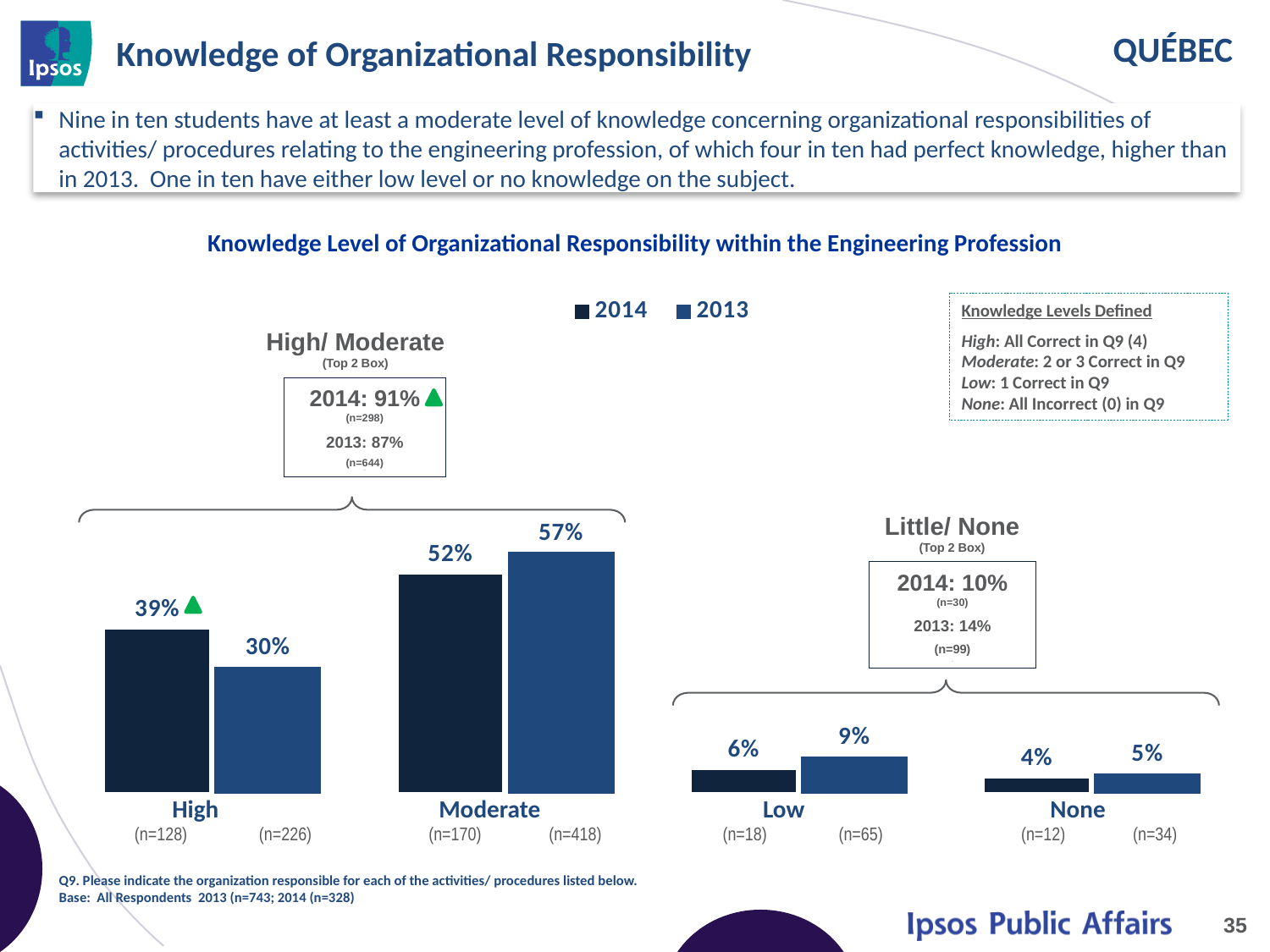
What kind of chart is shown on the slide? Bar chart Which is larger for the Moderate category, the 2014 value or the 2013 value? 2013 What is the difference between the 2014 and 2013 values for the High category? 9% What is the 2013 value for the Moderate category? 57% How many series does the legend list? 2 What is the 2014 value for the Low category? 6% Which category has the highest 2014 value? Moderate What is the 2014 value for the High category? 39% What is the title of the chart? Knowledge Level of Organizational Responsibility within the Engineering Profession What is the 2013 value for the None category? 5% Which category has the lowest 2013 value? None How many categories are shown on the x axis of the chart? 4